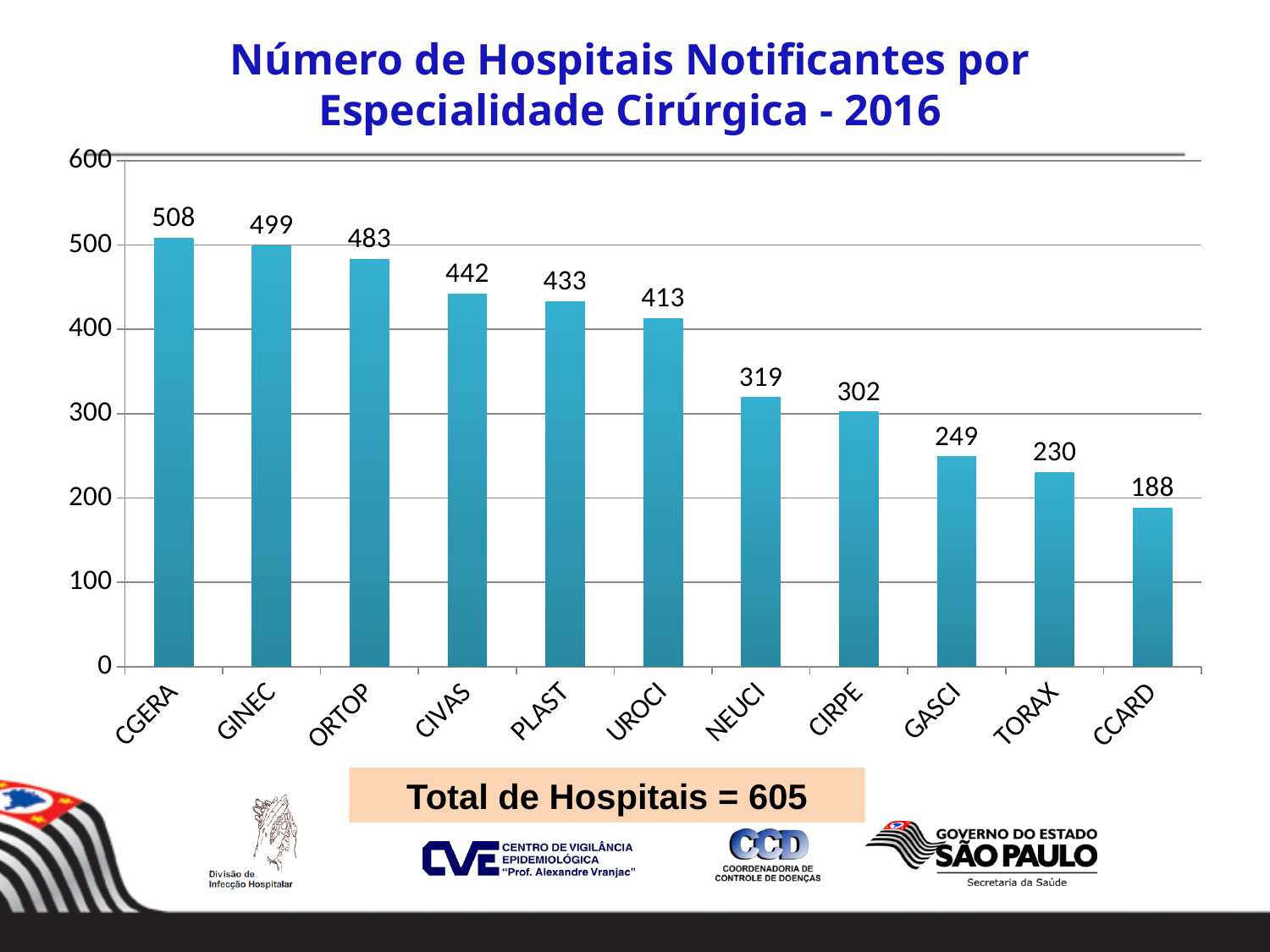
Which category has the lowest value? CCARD How many categories are shown on the x axis? 11 Is the value for GASCI greater or less than 300? less Which category has the highest value? CGERA What is the value for CGERA? 508 What kind of chart is shown on the slide? bar chart What is the value for CCARD? 188 What is the value for NEUCI? 319 What is the difference between the values for GINEC and ORTOP? 16 What is the difference between the values for CGERA and CCARD? 320 Do the values rise or fall from left to right along the x axis? fall Which is larger, the value for CIVAS or the value for UROCI? CIVAS